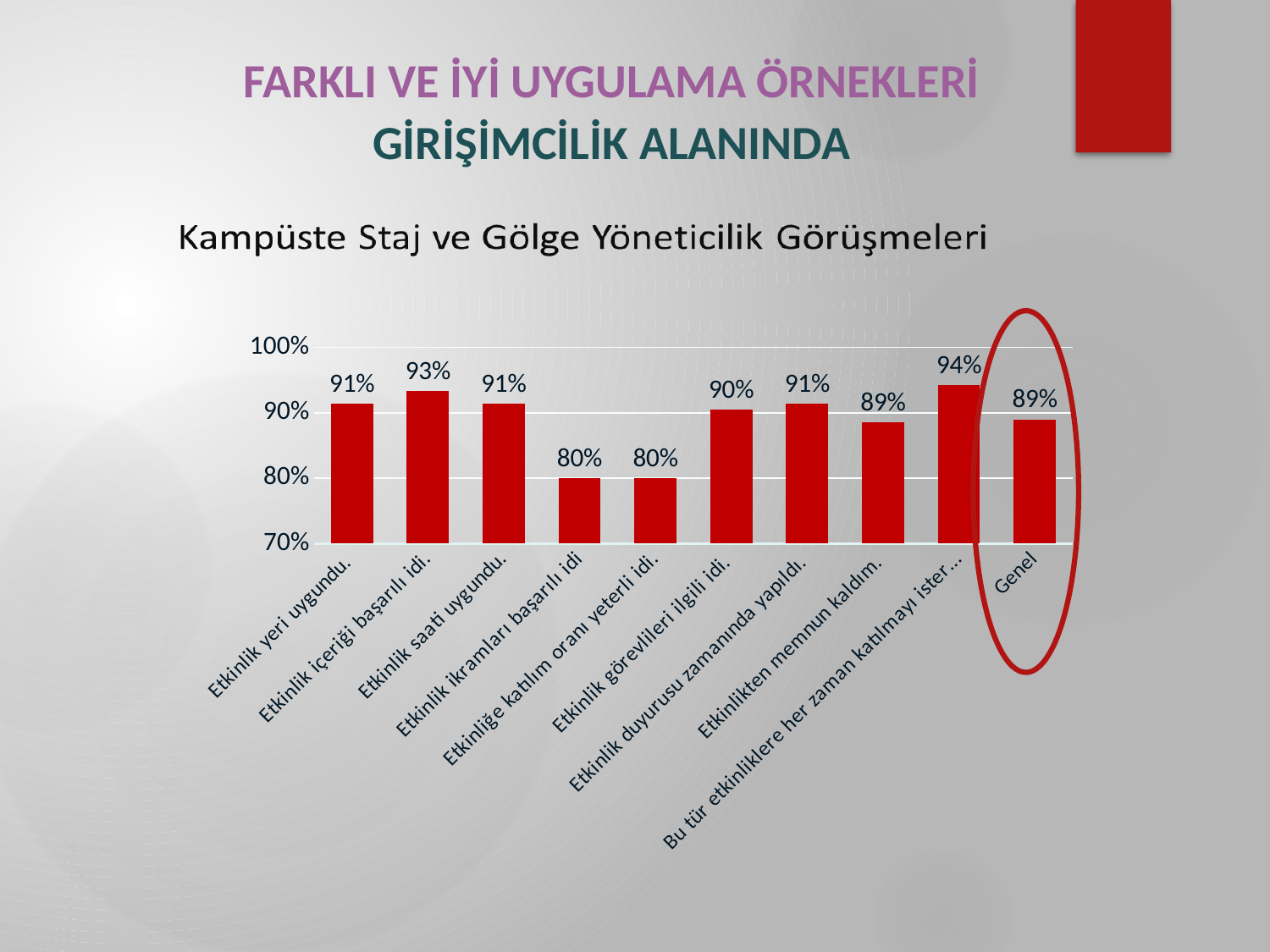
Which is larger, the value for "Etkinlik yeri uygundu." or the value for "Etkinliğe katılım oranı yeterli idi."? Etkinlik yeri uygundu. What is the value for "Etkinlik ikramları başarılı idi"? 80% What is the lowest value shown in the chart? 80% What is the value for "Genel"? 89% Is the value for "Etkinlik ikramları başarılı idi" greater or less than 90%? less What kind of chart is shown on the slide? bar chart What is the value for "Etkinlik içeriği başarılı idi."? 93% How many categories are shown in the chart? 10 What is the difference between the values for "Etkinlik içeriği başarılı idi." and "Genel"? 4 percentage points Which category on the chart is circled in red? Genel What is the highest value shown in the chart? 94% What is the value for "Etkinlikten memnun kaldım."? 89%